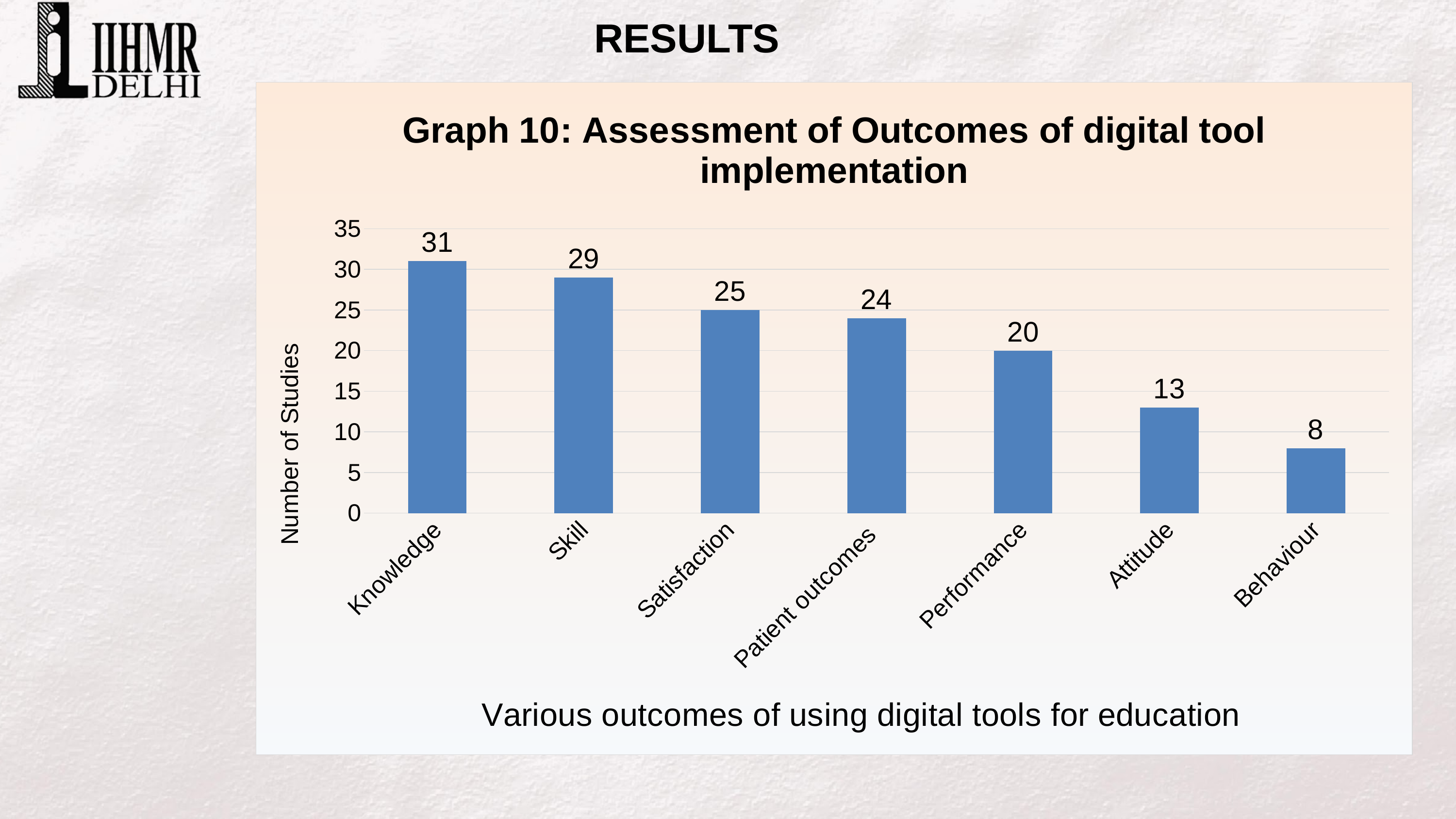
What is the label of the y axis? Number of Studies Which has more studies, Satisfaction or Attitude? Satisfaction What is the difference in number of studies between Knowledge and Behaviour? 23 How many outcome categories are shown in the chart? 7 What kind of chart is shown on the slide? Bar chart Do the values rise or fall moving from left to right along the x axis? Fall What is the number of studies for Attitude? 13 Which outcome has the highest number of studies? Knowledge What is the number of studies for Patient outcomes? 24 What is the difference in number of studies between Skill and Performance? 9 What is the number of studies for Knowledge? 31 Which outcome has the lowest number of studies? Behaviour